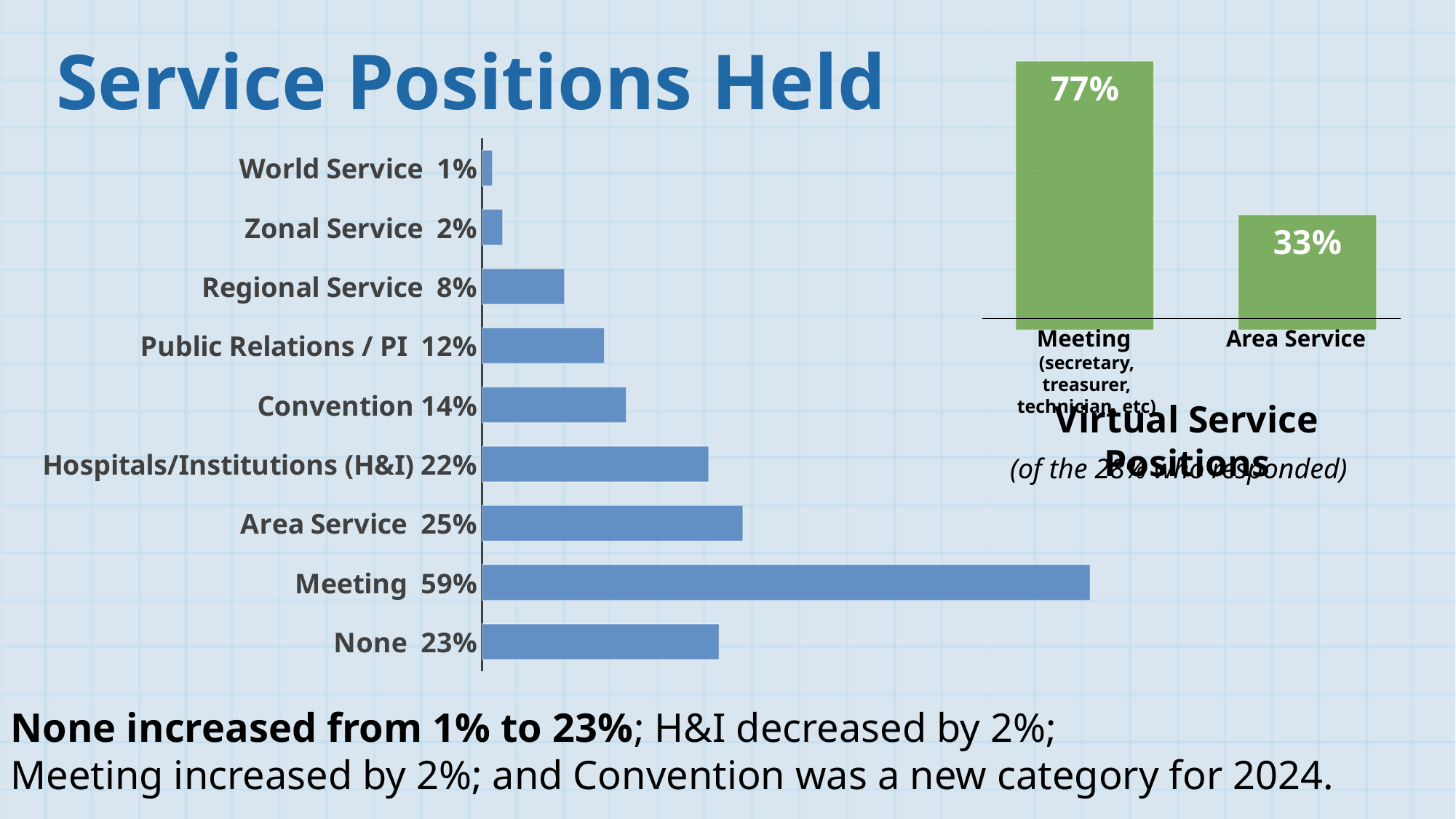
What kind of chart is the Service Positions Held chart? Bar chart In the Service Positions Held chart, which category has the lowest value? World Service In the Service Positions Held chart, which category has the highest value? Meeting In the Service Positions Held chart, what is the value for Hospitals/Institutions (H&I)? 22% In the Virtual Service Positions chart, what is the value for Meeting? 77% In the Service Positions Held chart, which is larger, None or Hospitals/Institutions (H&I)? None What colour are the bars in the Virtual Service Positions chart? Green In the Virtual Service Positions chart, what is the difference between Meeting and Area Service? 44% In the Virtual Service Positions chart, what is the value for Area Service? 33% How many categories does the Service Positions Held chart show? 9 In the Service Positions Held chart, what is the difference between Area Service and Regional Service? 17% In the Service Positions Held chart, what is the value for Meeting? 59%